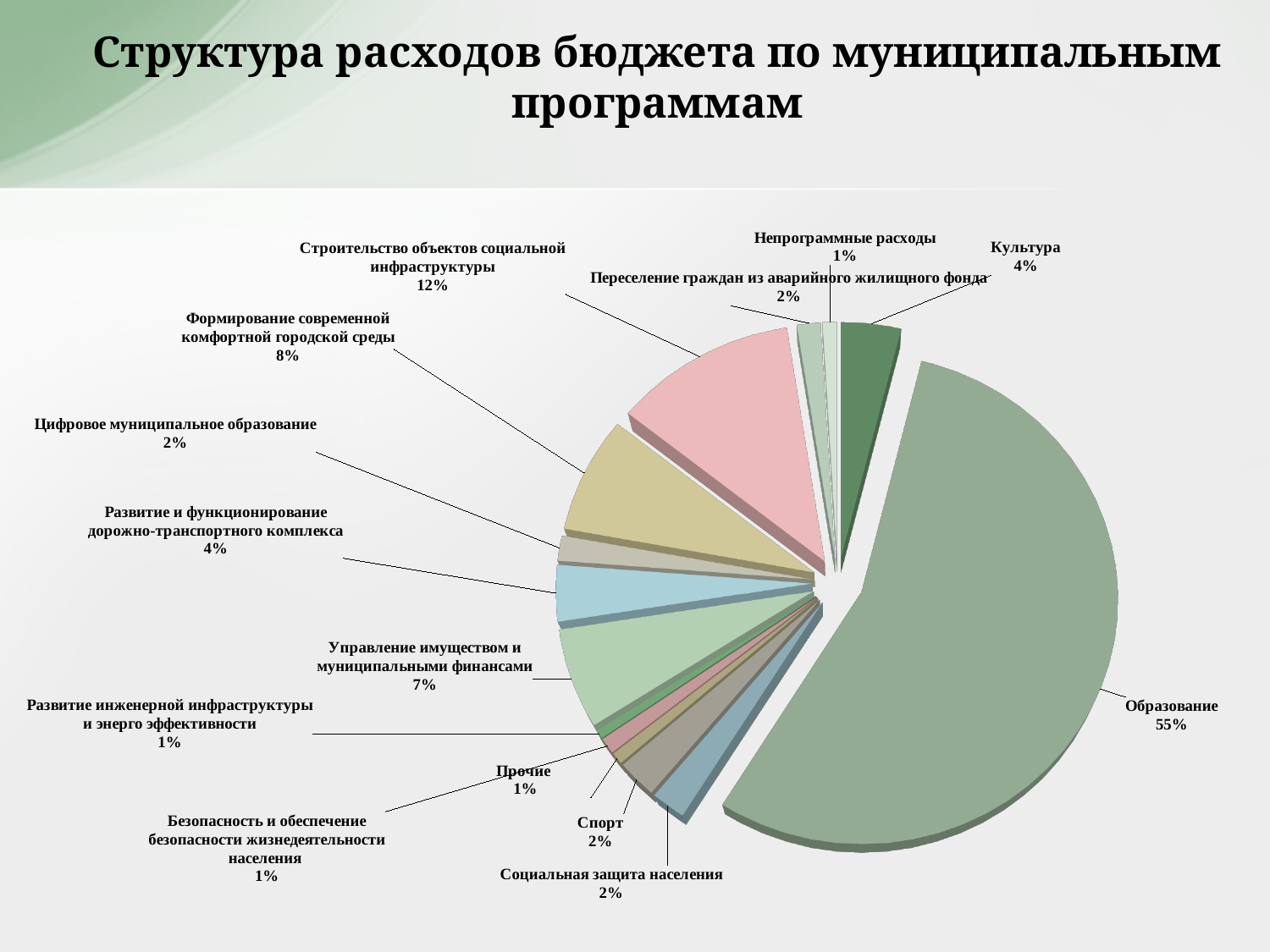
What is the value for Культура? 4% What share of the pie does Образование have? 55% Which is larger, the value for Формирование современной комфортной городской среды or the value for Управление имуществом и муниципальными финансами? Формирование современной комфортной городской среды What kind of chart is shown on the slide? pie chart Which category has the largest share of the pie? Образование What is the value for Строительство объектов социальной инфраструктуры? 12% What is the title of the slide? Структура расходов бюджета по муниципальным программам What is the value for Управление имуществом и муниципальными финансами? 7% What is the value for Спорт? 2% What is the value for Формирование современной комфортной городской среды? 8% How many categories are shown in the pie chart? 14 What is the difference between the values for Образование and Строительство объектов социальной инфраструктуры? 43%